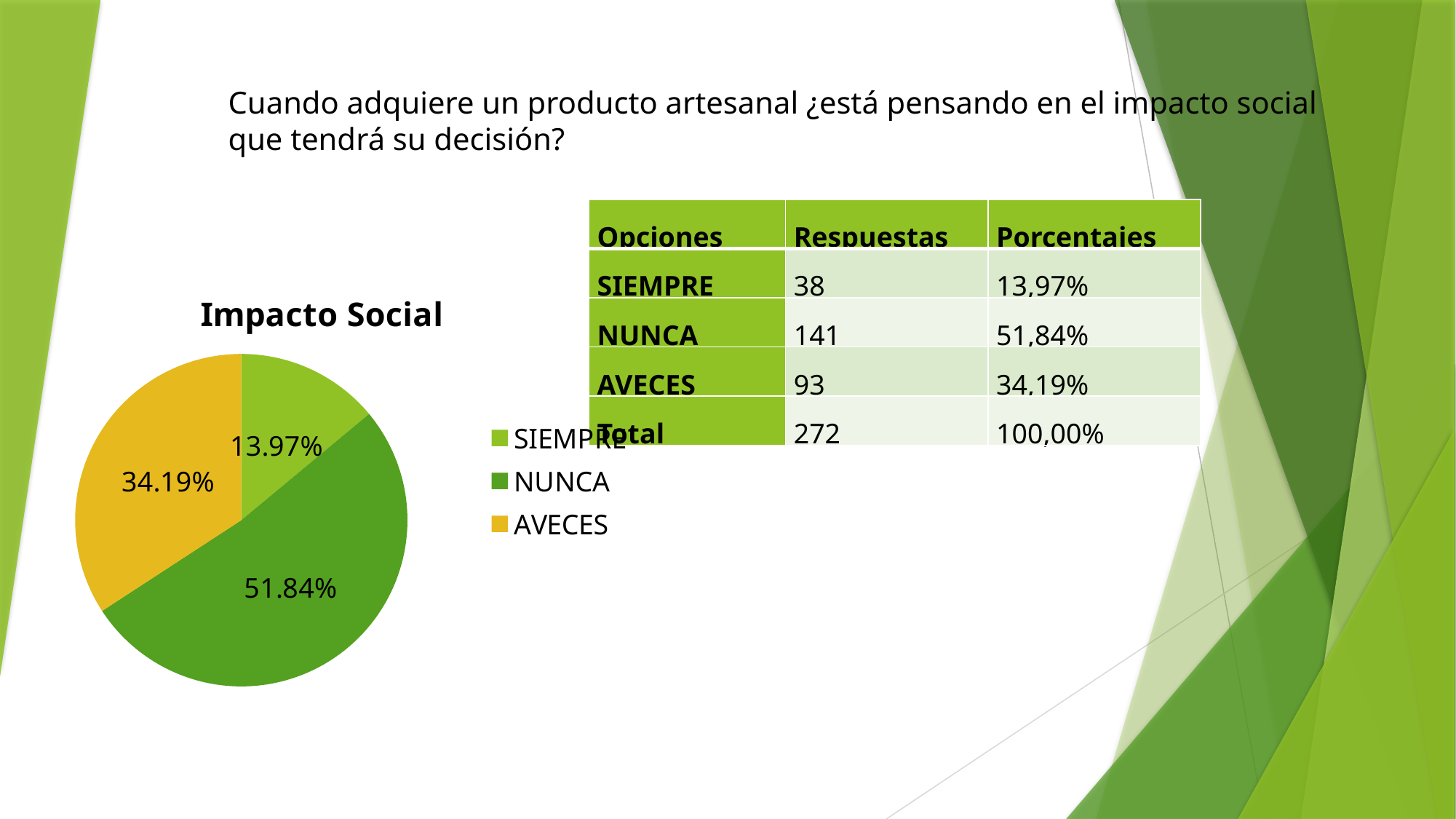
What kind of chart is shown on the slide? pie chart How many slices does the pie chart have? 3 Which slice is larger, AVECES or SIEMPRE? AVECES What percentage does the AVECES slice show? 34.19% What is the title of the chart? Impacto Social Which category has the smallest slice of the pie? SIEMPRE Which colour represents AVECES in the pie chart? yellow How many entries does the legend list? 3 Which category has the largest slice of the pie? NUNCA What percentage does the NUNCA slice show? 51.84% What percentage does the SIEMPRE slice show? 13.97% What is the difference in percentage points between the NUNCA slice and the AVECES slice? 17.65